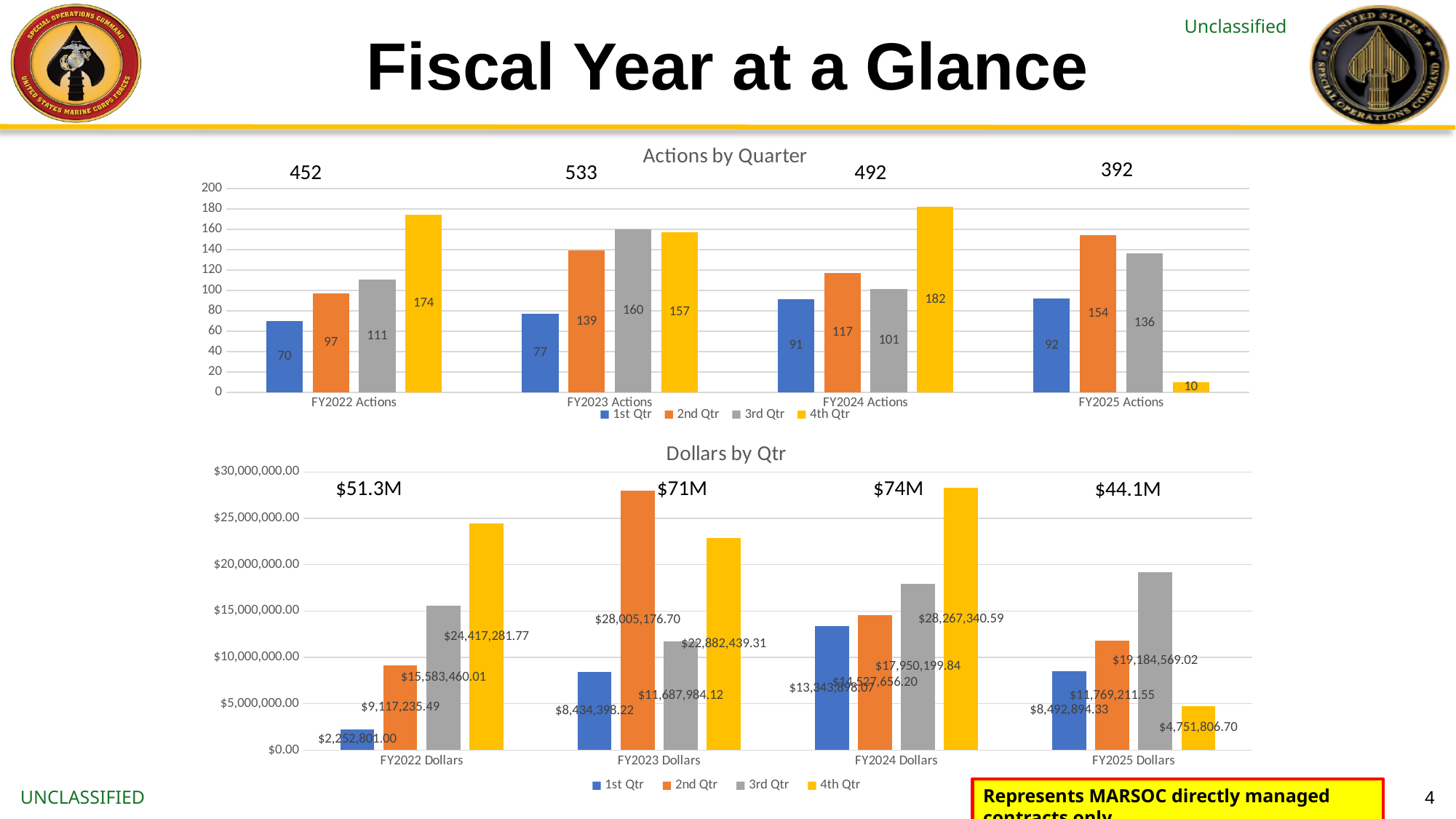
In the Dollars by Qtr chart, which quarter has the highest value for FY2023 Dollars? 2nd Qtr In the Actions by Quarter chart, what is the value for the 4th Qtr of FY2022 Actions? 174 In the Dollars by Qtr chart, what is the value for the 3rd Qtr of FY2025 Dollars? $19,184,569.02 In the Actions by Quarter chart, what is the total of actions shown above FY2023 Actions? 533 What kind of chart is the Dollars by Qtr chart? bar chart In the Actions by Quarter chart, what is the value for the 3rd Qtr of FY2023 Actions? 160 In the Actions by Quarter chart, which is larger: the 3rd Qtr value for FY2022 Actions or the 3rd Qtr value for FY2024 Actions? FY2022 Actions In the Actions by Quarter chart, which quarter has the lowest value for FY2025 Actions? 4th Qtr How many series does the legend of the Dollars by Qtr chart list? 4 In the Actions by Quarter chart, which quarter has the highest value for FY2024 Actions? 4th Qtr In the Actions by Quarter chart, what is the difference between the 2nd Qtr and 1st Qtr values for FY2023 Actions? 62 In the Actions by Quarter chart, do the values for FY2022 Actions rise or fall from 1st Qtr to 4th Qtr? rise